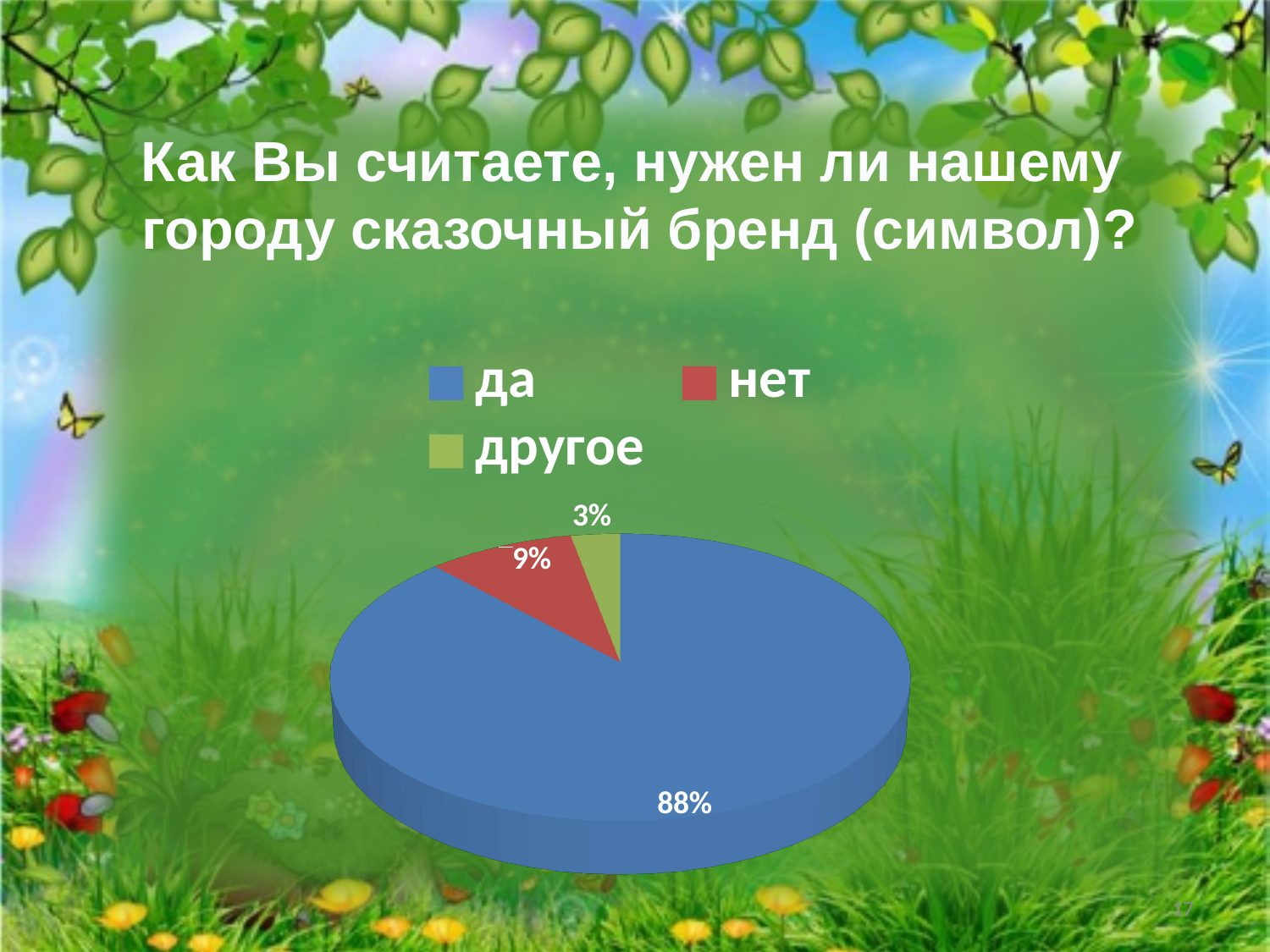
What kind of chart is shown on the slide? pie chart What is the difference in percentage points between "да" and "нет"? 79 What share of the pie does "нет" have? 9% Which category has the largest slice of the pie? да Which is larger, the share for "нет" or the share for "другое"? нет What colour is the slice for "нет"? red What share of the pie does "да" have? 88% Which category has the smallest slice of the pie? другое What is the title of the chart? Как Вы считаете, нужен ли нашему городу сказочный бренд (символ)? What share of the pie does "другое" have? 3% How many categories does the pie chart show? 3 What is the difference in percentage points between "нет" and "другое"? 6